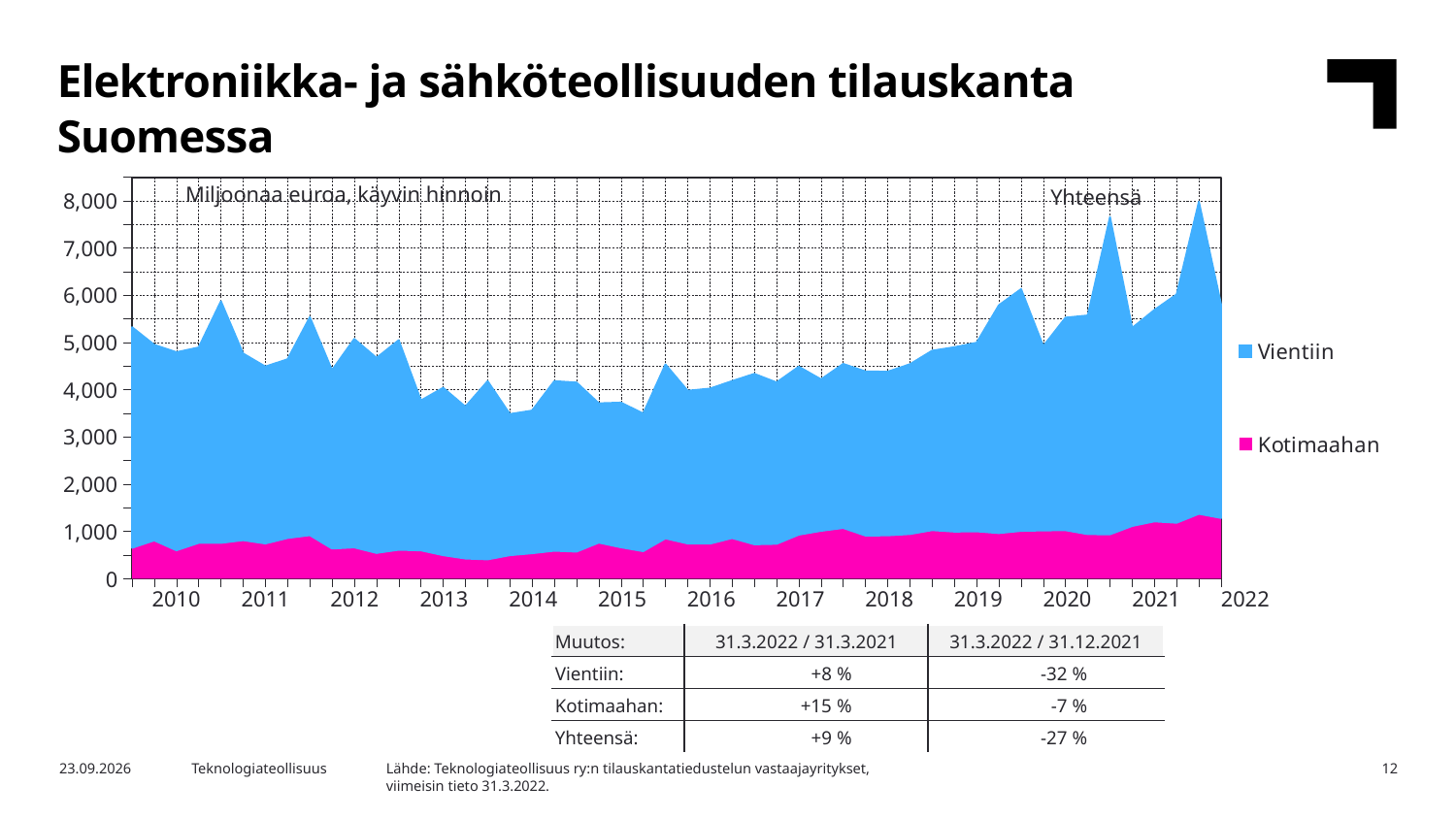
Which series is larger throughout the chart, Vientiin or Kotimaahan? Vientiin What kind of chart is shown on the slide? Area chart What are the two series named in the chart legend? Vientiin and Kotimaahan Is the total (Yhteensä) value at the peak in 2020 greater or less than 7,000? greater How many series does the chart legend list? 2 According to the table below the chart, what is the change in Vientiin for 31.3.2022 / 31.3.2021? +8 % Does the Kotimaahan series generally rise or fall from 2010 to 2022? rise Is the total (Yhteensä) value at the start of 2010 greater or less than 4,000? greater Is the Kotimaahan value in 2021 greater or less than 2,000? less How many year labels are shown on the x axis? 13 What unit is stated in the chart's subtitle? Miljoonaa euroa, käyvin hinnoin